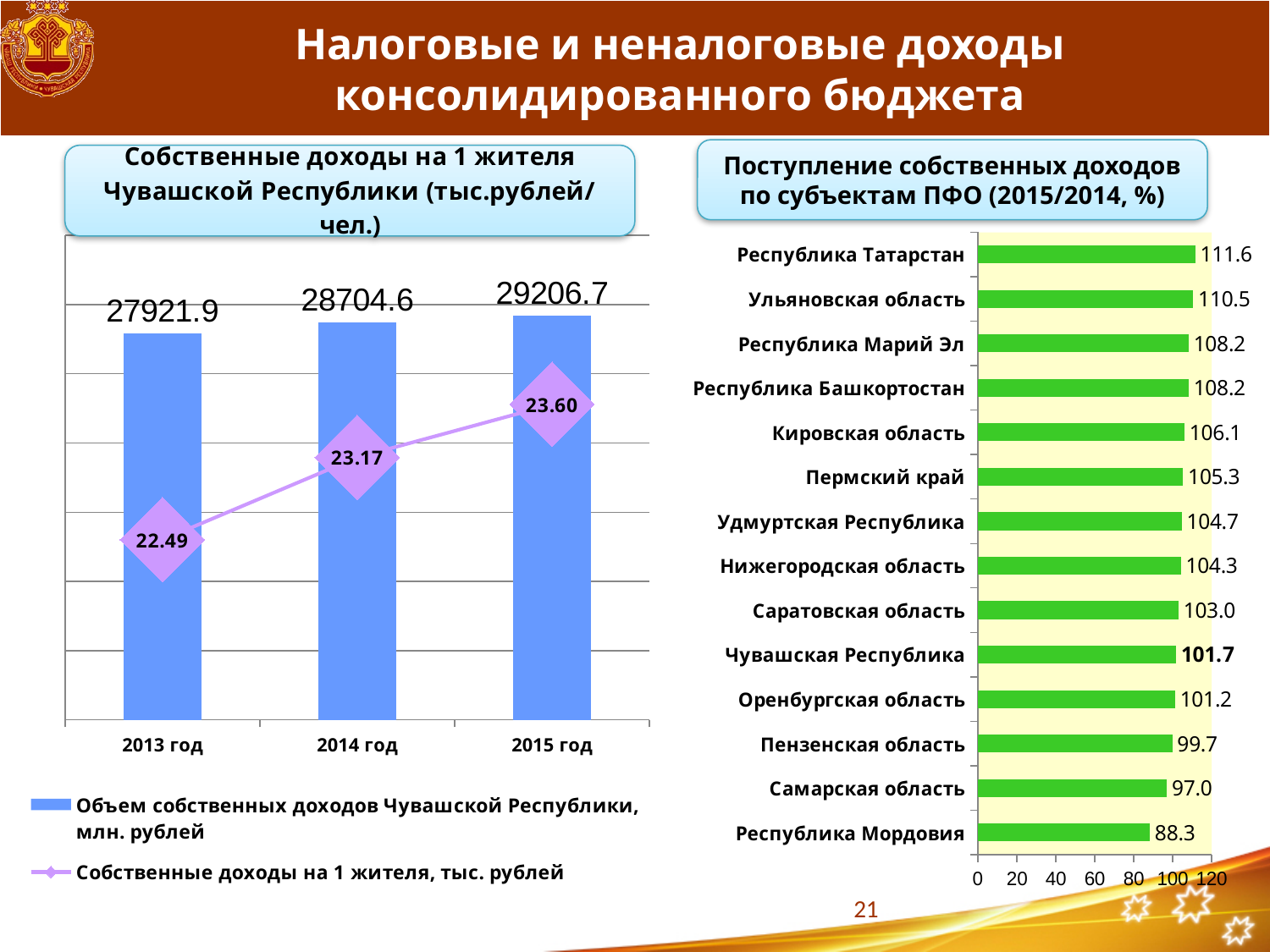
In the right chart (Поступление собственных доходов по субъектам ПФО), which region has the highest value? Республика Татарстан In the left chart, what is the value of the line marker (Собственные доходы на 1 жителя) for 2013 год? 22.49 How many series does the legend of the left chart list? 2 In the left chart, what is the value of the bar for 2015 год? 29206.7 In the right chart, what is the difference between the values for Республика Татарстан and Республика Мордовия? 23.3 How many regions are shown in the right chart? 14 In the left chart, by how much did the bar value increase from 2013 год to 2014 год? 782.7 In the right chart, which region has the lowest value? Республика Мордовия What type of chart is the right chart? bar chart In the right chart, which has a larger value: Кировская область or Пензенская область? Кировская область In the right chart, what is the value for Чувашская Республика? 101.7 In the left chart, do the line values rise or fall from 2013 год to 2015 год? rise